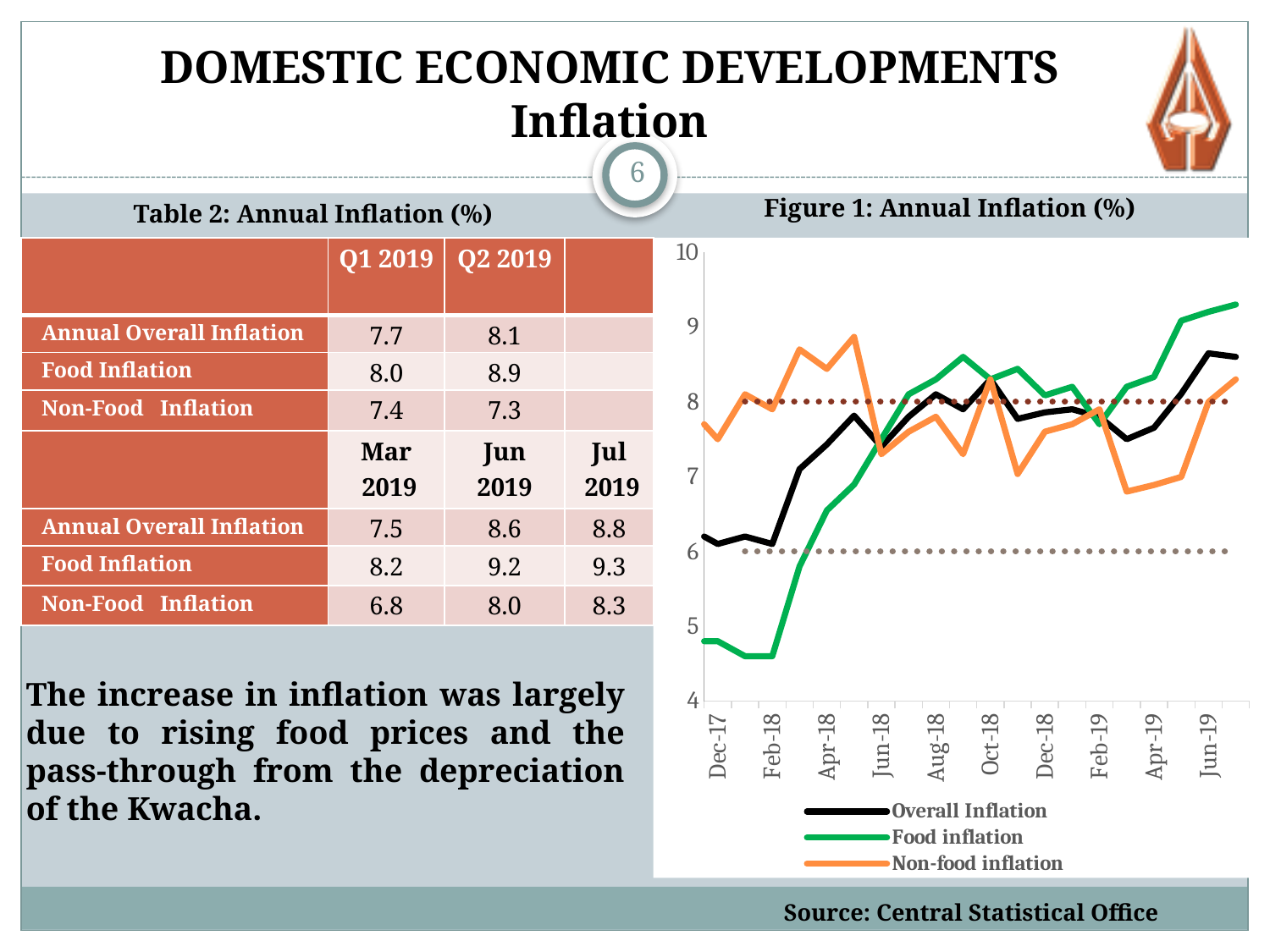
In Figure 1, is the value for Food inflation at Dec-17 greater or less than 6? less In Figure 1, what colour is the Food inflation line? Green In Figure 1, is the value for Food inflation at Jun-19 greater or less than 9? greater In Figure 1, which series has the highest value at Jun-19? Food inflation In Figure 1, which series has the lowest value at Dec-17? Food inflation In Figure 1, which is larger at Dec-17: Food inflation or Non-food inflation? Non-food inflation In Figure 1, is the value for Overall Inflation at Dec-17 greater or less than 7? less What type of chart is Figure 1: Annual Inflation (%)? Line chart How many series does the legend of Figure 1 list? 3 In Figure 1, does Food inflation rise or fall overall from Dec-17 to Jun-19? Rise